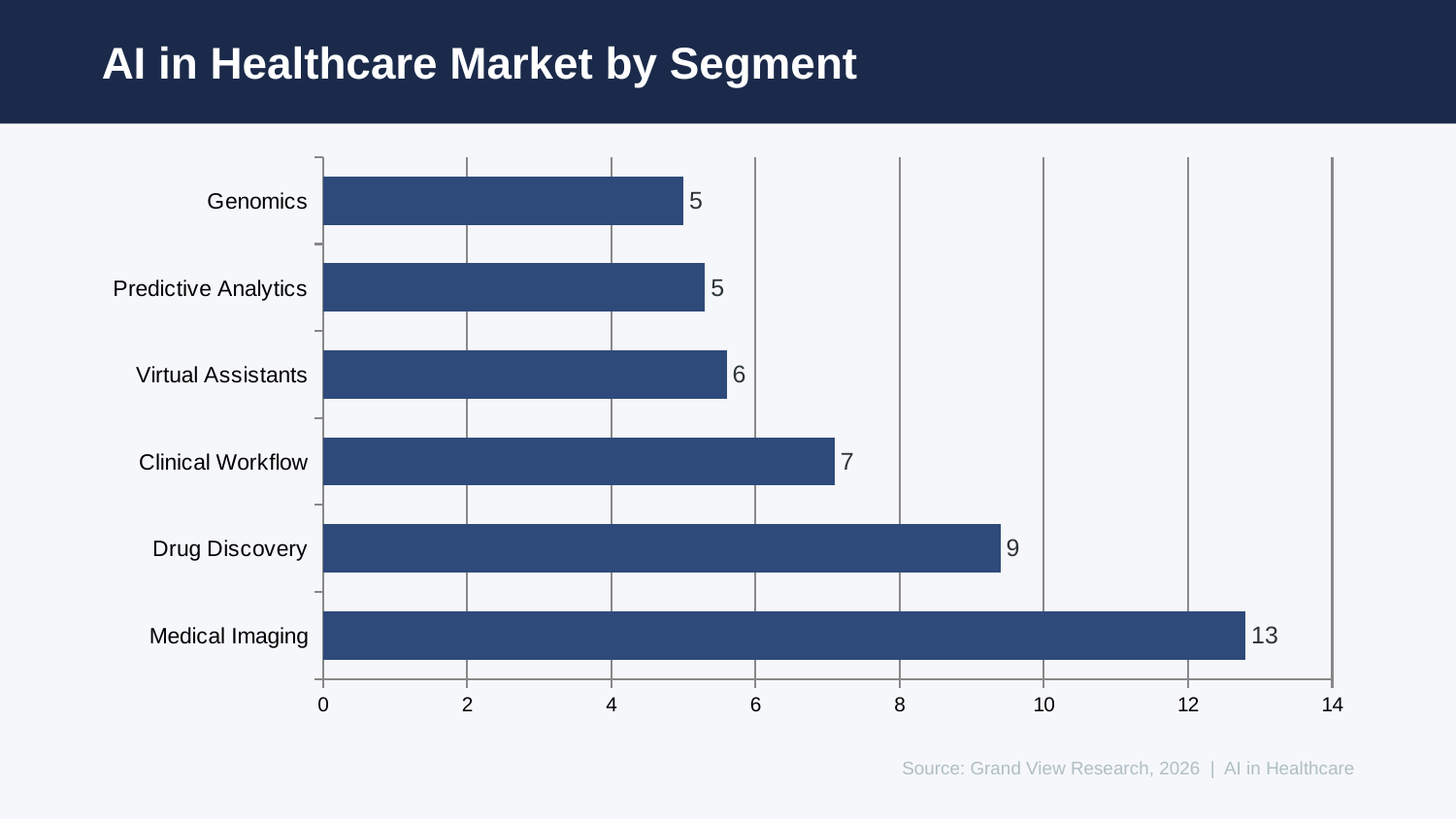
What is the difference between the values for Clinical Workflow and Virtual Assistants? 1 Which is larger, the value for Drug Discovery or the value for Clinical Workflow? Drug Discovery How many segments are shown in the chart? 6 What is the difference between the values for Medical Imaging and Drug Discovery? 4 What is the value for Drug Discovery? 9 What is the title of the chart? AI in Healthcare Market by Segment Is the value for Drug Discovery greater or less than 8? greater What is the value for Medical Imaging? 13 What is the value for Virtual Assistants? 6 What is the value for Clinical Workflow? 7 What kind of chart is shown on the slide? bar chart Which segment has the highest value? Medical Imaging